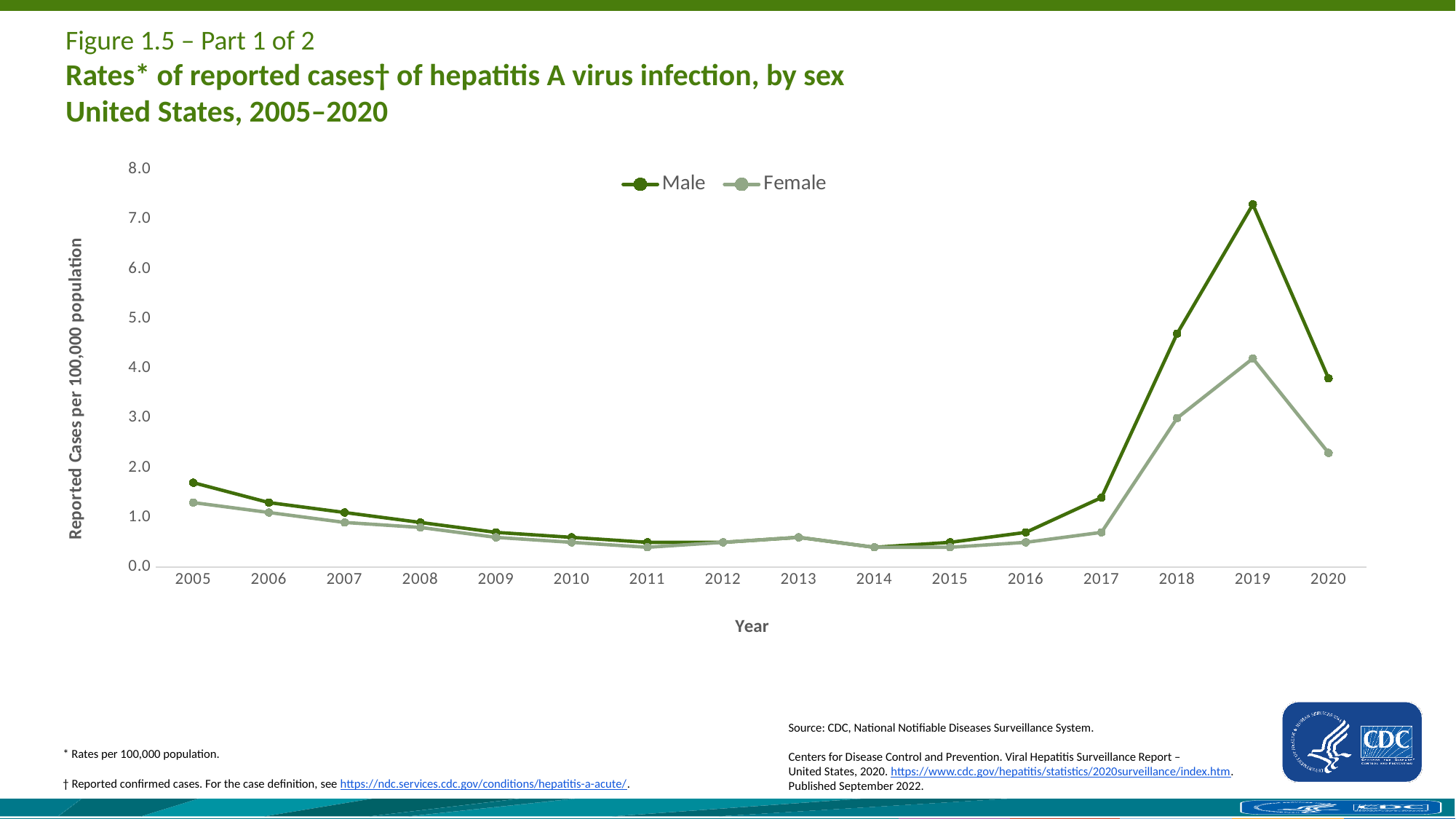
Is the Male rate in 2019 greater or less than 7.0? greater How many series does the legend list? 2 In which year does the Male rate reach its highest value? 2019 What is the label of the y axis? Reported Cases per 100,000 population Does the Male rate rise or fall from 2005 to 2011? fall What kind of chart is shown on the slide? line chart Is the Male rate in 2018 greater or less than 5.0? less How many years are plotted along the x axis? 16 Is the Female rate in 2020 greater or less than 2.0? greater In which year does the Female rate reach its highest value? 2019 Which series has the higher rate in 2019, Male or Female? Male